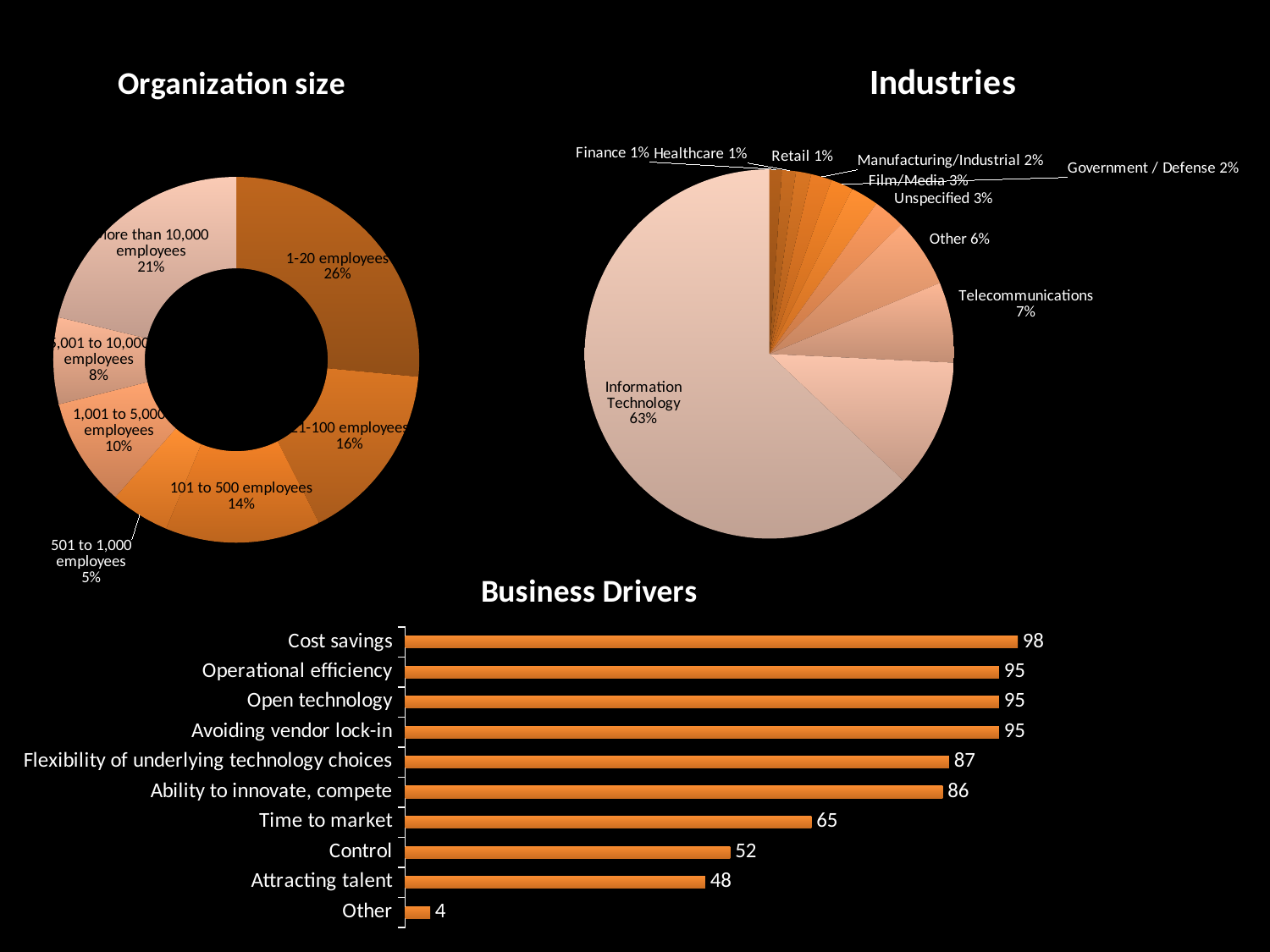
In the Business Drivers chart, which is larger: Attracting talent or Time to market? Time to market In the Business Drivers chart, how many categories are shown? 10 In the Industries chart, what is the difference between Telecommunications and Other? 1% In the Industries chart, what share does Information Technology have? 63% What kind of chart is the Business Drivers chart? bar chart What is the title of the chart at the top right of the slide? Industries In the Organization size chart, what share do organizations with 1-20 employees have? 26% In the Organization size chart, which category has the smallest share? 501 to 1,000 employees In the Business Drivers chart, what is the difference between Time to market and Control? 13 In the Business Drivers chart, which category has the lowest value? Other In the Business Drivers chart, what is the value for Cost savings? 98 In the Business Drivers chart, which category has the highest value? Cost savings